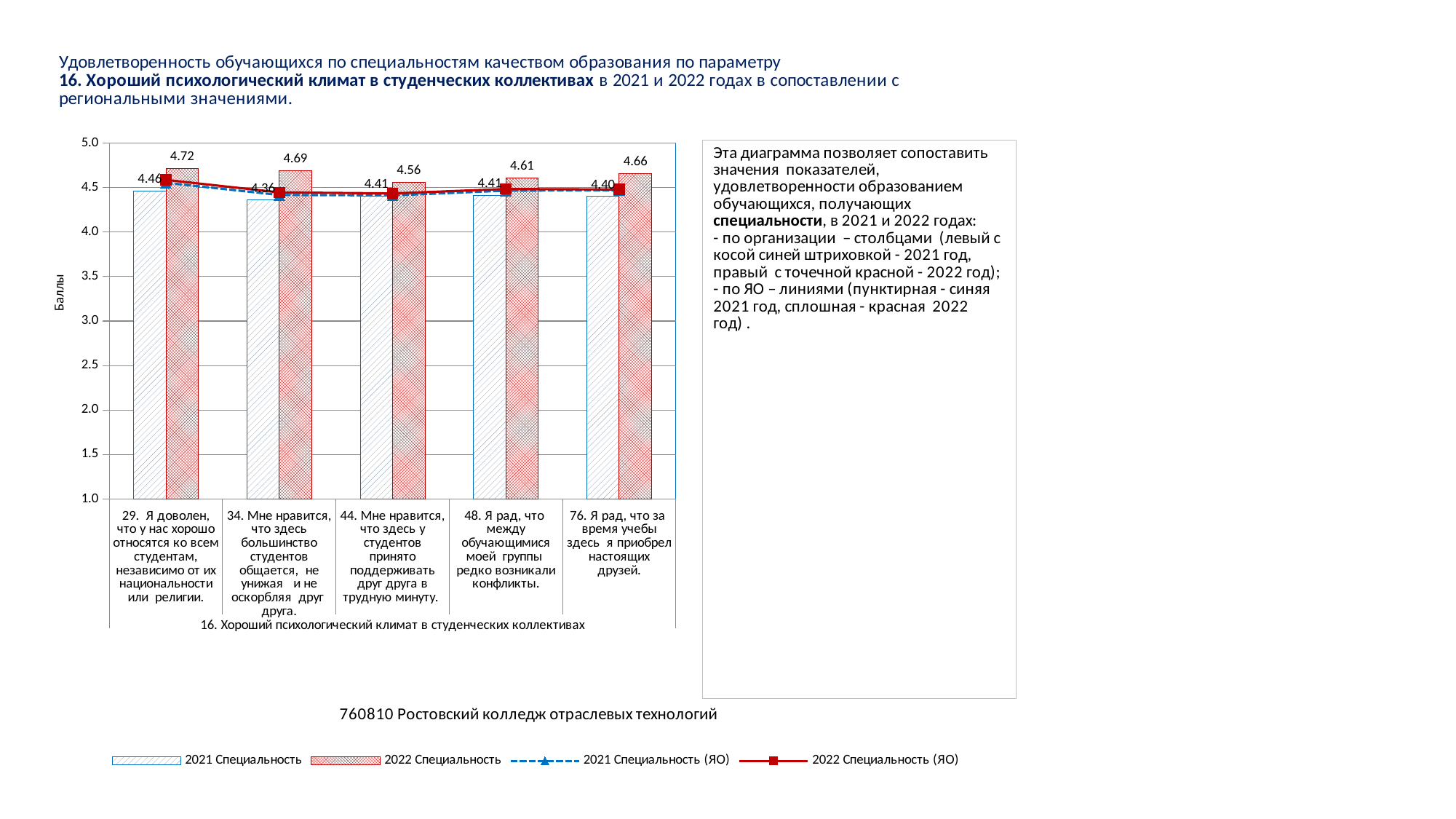
What is the label of the vertical axis of the chart? Баллы What is the value of the 2021 Специальность bar for category 76 (Я рад, что за время учебы здесь я приобрел настоящих друзей)? 4.40 What is the value of the 2021 Специальность bar for category 34 (Мне нравится, что здесь большинство студентов общается, не унижая и не оскорбляя друг друга)? 4.36 How many categories (questions) are shown on the x axis of the chart? 5 Which category has the highest 2022 Специальность bar? 29. Я доволен, что у нас хорошо относятся ко всем студентам, независимо от их национальности или религии. Is the value of the 2022 Специальность (ЯО) line for category 29 greater or less than 4.0? greater What is the value of the 2022 Специальность bar for category 44 (Мне нравится, что здесь у студентов принято поддерживать друг друга в трудную минуту)? 4.56 What is the difference between the 2022 and 2021 Специальность bars for category 48 (Я рад, что между обучающимися моей группы редко возникали конфликты)? 0.20 Which category has the lowest 2021 Специальность bar? 34. Мне нравится, что здесь большинство студентов общается, не унижая и не оскорбляя друг друга. For category 76, which is larger: the 2021 Специальность bar or the 2022 Специальность bar? 2022 Специальность What is the value of the 2022 Специальность bar for category 29 (Я доволен, что у нас хорошо относятся ко всем студентам)? 4.72 How many series does the chart legend list? 4